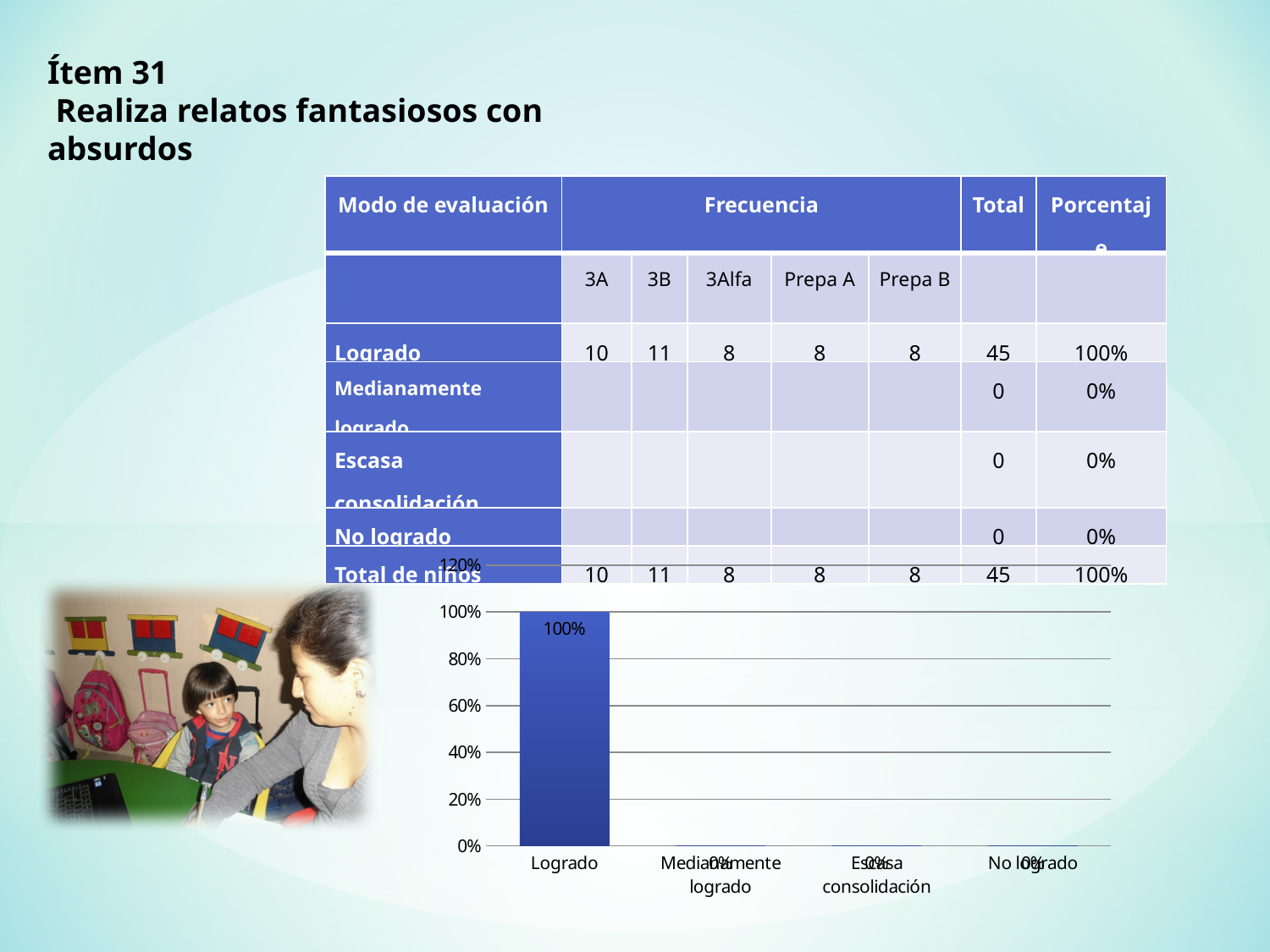
What type of chart is shown on the slide? bar chart What is the value shown for No logrado? 0% What is the value of the bar for Logrado? 100% Is the value for Logrado greater or less than 80%? greater Do the values rise or fall from Logrado to No logrado along the x axis? fall What is the difference between the values for Logrado and Escasa consolidación? 100% What is the value shown for Escasa consolidación? 0% Which is larger, the value for Logrado or the value for No logrado? Logrado How many categories are shown on the x axis of the chart? 4 What is the highest tick label shown on the y axis of the chart? 120% Which category has the highest value in the chart? Logrado What is the value shown for Medianamente logrado? 0%